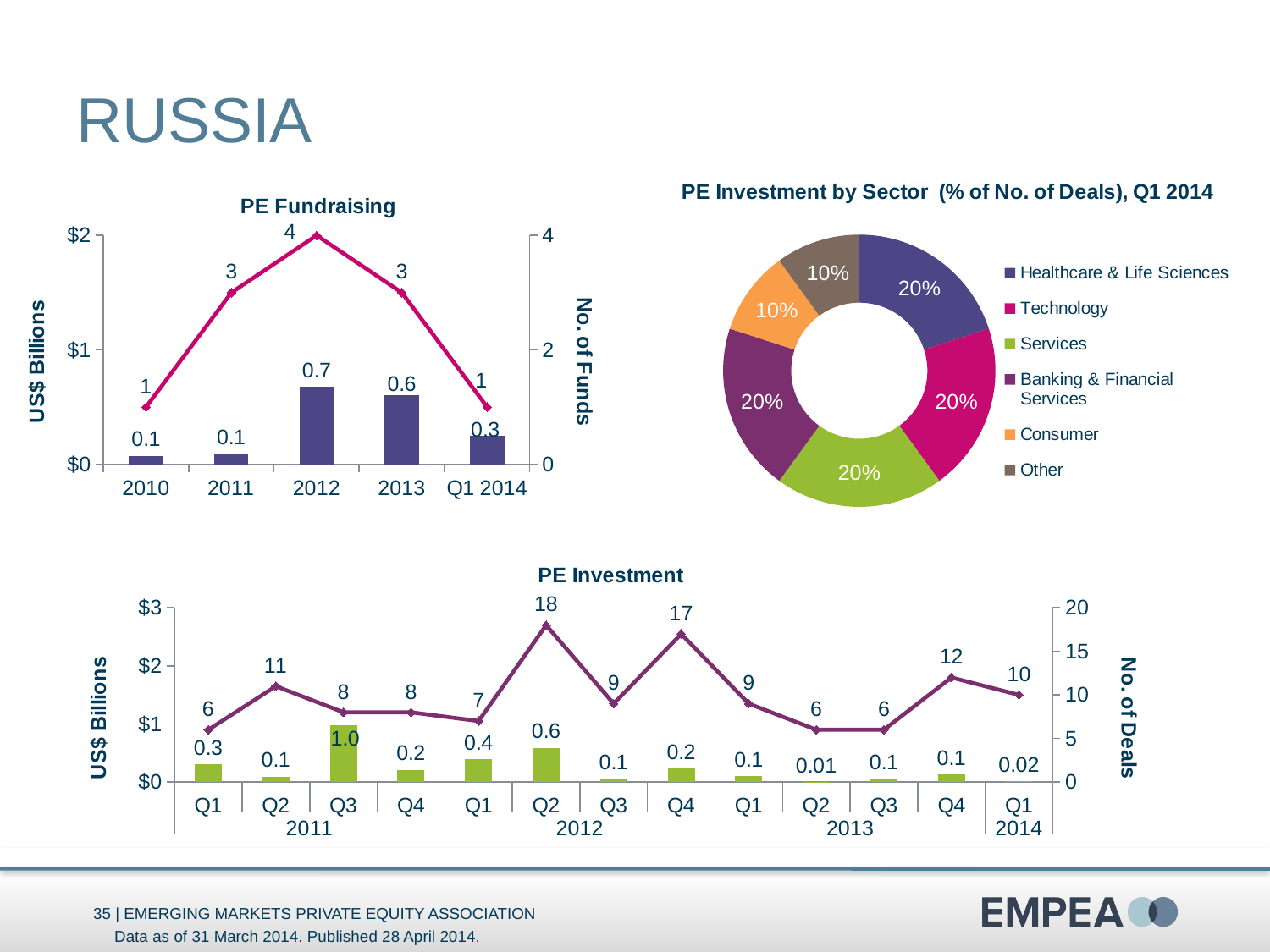
In the PE Investment chart, what is the difference in number of deals between Q2 2012 and Q3 2012? 9 In the PE Investment by Sector chart, what share of deals in Q1 2014 was in Consumer? 10% In the PE Fundraising chart, what was the fundraising value in US$ billions for 2012? 0.7 In the PE Investment chart, which quarter had the highest number of deals? Q2 2012 In the PE Fundraising chart, what is the difference in US$ billions between the 2012 and 2013 fundraising values? 0.1 In the PE Fundraising chart, how many funds were raised in 2013? 3 In the PE Investment chart, what was the investment value in US$ billions for Q3 2011? 1.0 In the PE Fundraising chart, which year had the highest number of funds? 2012 In the PE Investment chart, which is larger: the number of deals in Q4 2012 or in Q1 2013? Q4 2012 In the PE Investment chart, how many deals were there in Q4 2013? 12 What kind of chart is the PE Investment by Sector chart? Doughnut (pie) chart How many sectors does the legend of the PE Investment by Sector chart list? 6